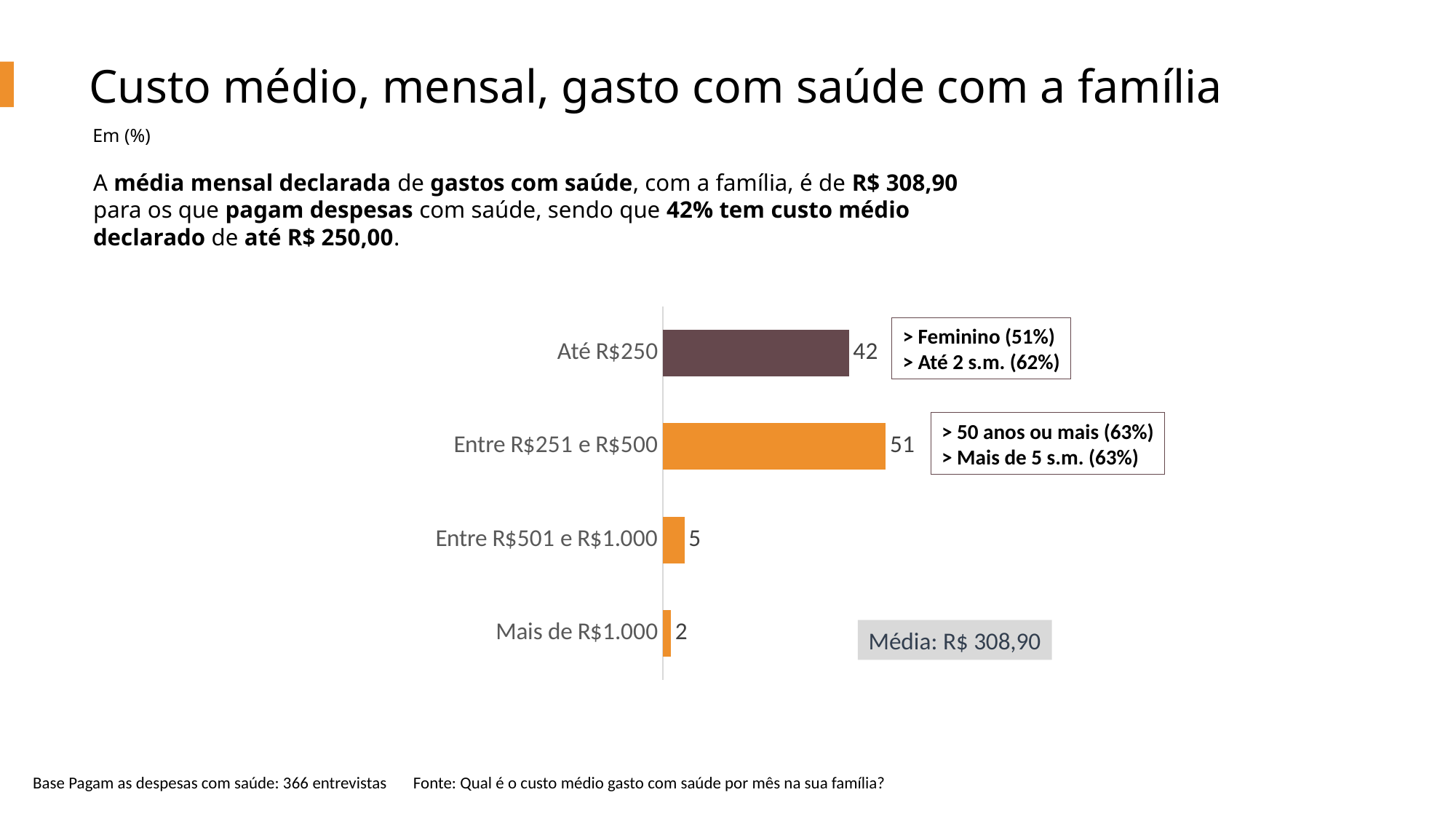
What is the difference between the values for "Entre R$251 e R$500" and "Até R$250"? 9 What is the value for "Mais de R$1.000"? 2 Which category has the highest value? Entre R$251 e R$500 Which is larger, the value for "Até R$250" or the value for "Entre R$501 e R$1.000"? Até R$250 What is the value for "Entre R$501 e R$1.000"? 5 What is the total of the values for "Entre R$501 e R$1.000" and "Mais de R$1.000"? 7 What is the value for "Entre R$251 e R$500"? 51 How many categories are shown in the chart? 4 What kind of chart is shown on the slide? Bar chart What is the value for "Até R$250"? 42 What average (Média) is shown in the box on the chart? R$ 308,90 Which category has the lowest value? Mais de R$1.000